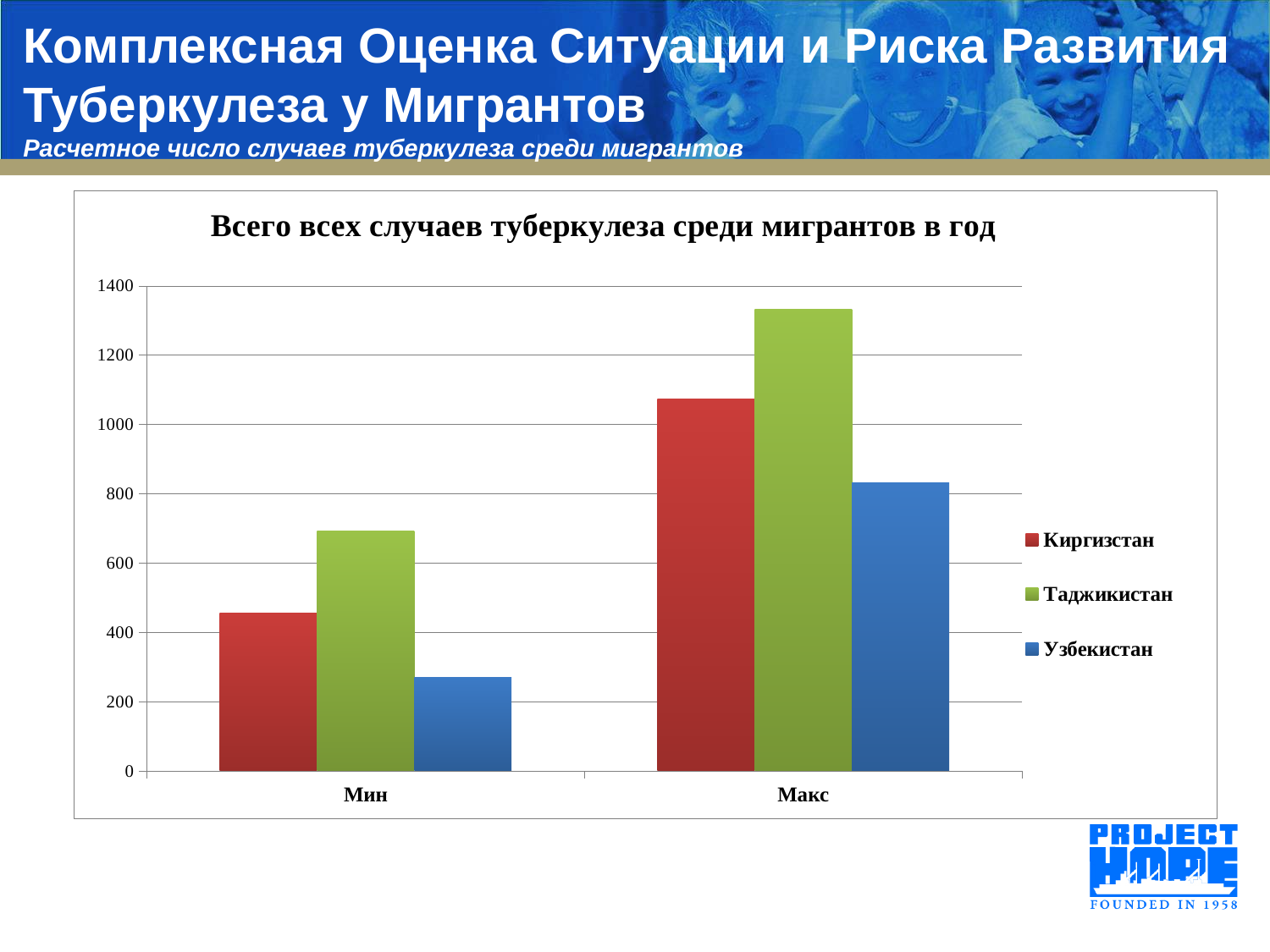
Which country has the lowest value in the Макс category? Узбекистан How many series does the legend list? 3 Is the value for Таджикистан in the Макс category greater or less than 1200? greater How many categories are shown on the x axis? 2 What kind of chart is shown on the slide? bar chart Which country has the highest value in the Макс category? Таджикистан Do the values for Узбекистан rise or fall from Мин to Макс? rise Is the value for Киргизстан in the Макс category greater or less than 1000? greater Which country has the lowest value in the Мин category? Узбекистан What is the title of the chart? Всего всех случаев туберкулеза среди мигрантов в год Which is larger: the value for Киргизстан in Мин or the value for Таджикистан in Мин? Таджикистан in Мин Is the value for Узбекистан in the Мин category greater or less than 400? less